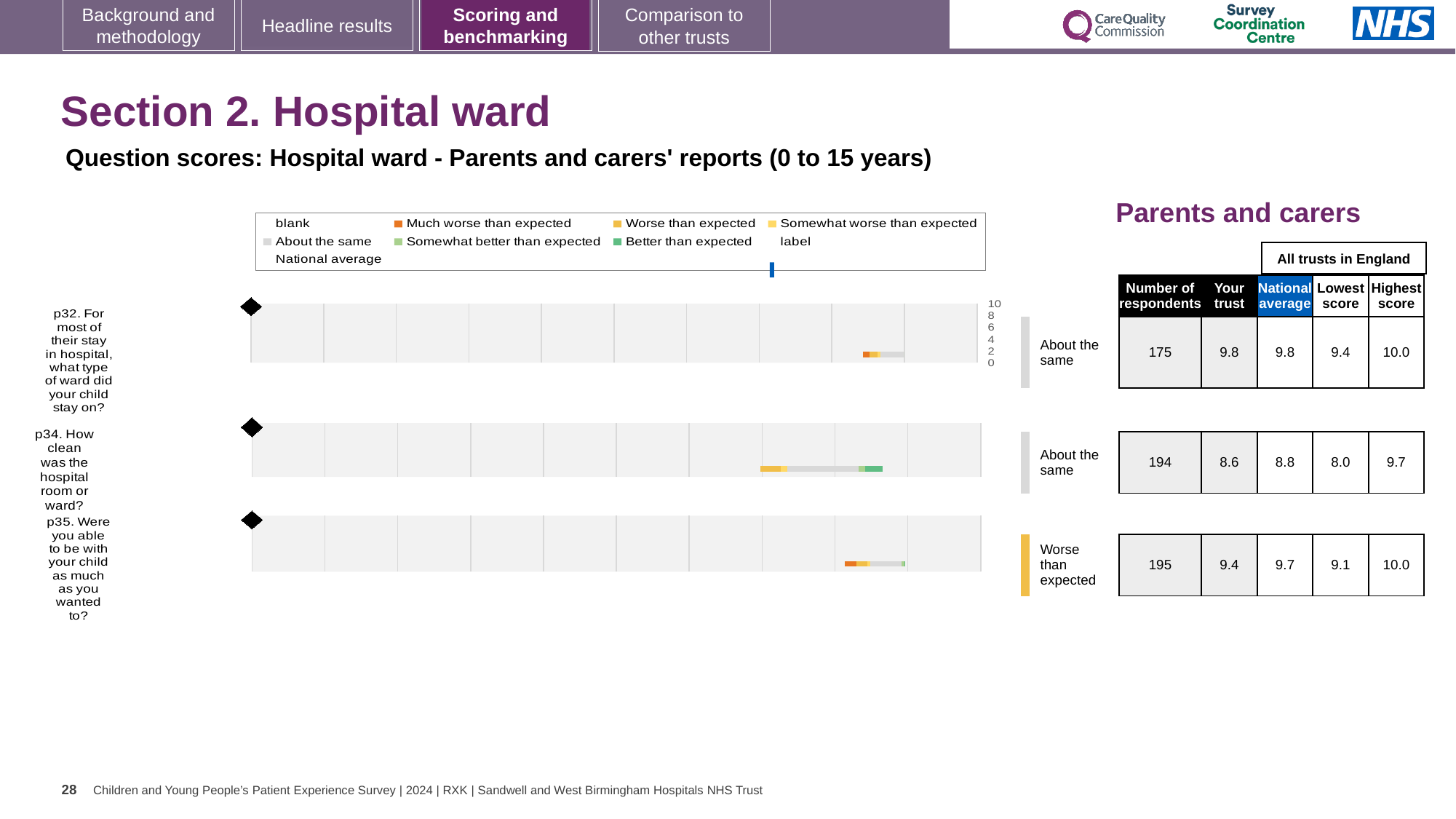
How many respondents answered p32 (For most of their stay in hospital, what type of ward did your child stay on?)? 175 What is the maximum value shown on the chart's score axis? 10 How many questions are plotted on this slide? 3 For p34, what is the difference between the highest score and the lowest score across all trusts in England? 1.7 What is the national average score for p35 (Were you able to be with your child as much as you wanted to?)? 9.7 What is the 'Your trust' score for p34 (How clean was the hospital room or ward?)? 8.6 For p35, what is the difference between the national average and the 'Your trust' score? 0.3 Which question has the lowest 'Your trust' score? p34 What is the highest score among all trusts in England for p34? 9.7 Which question has the highest 'Your trust' score? p32 What benchmark category is shown for p35? Worse than expected For p34, which is larger: the 'Your trust' score or the national average? National average